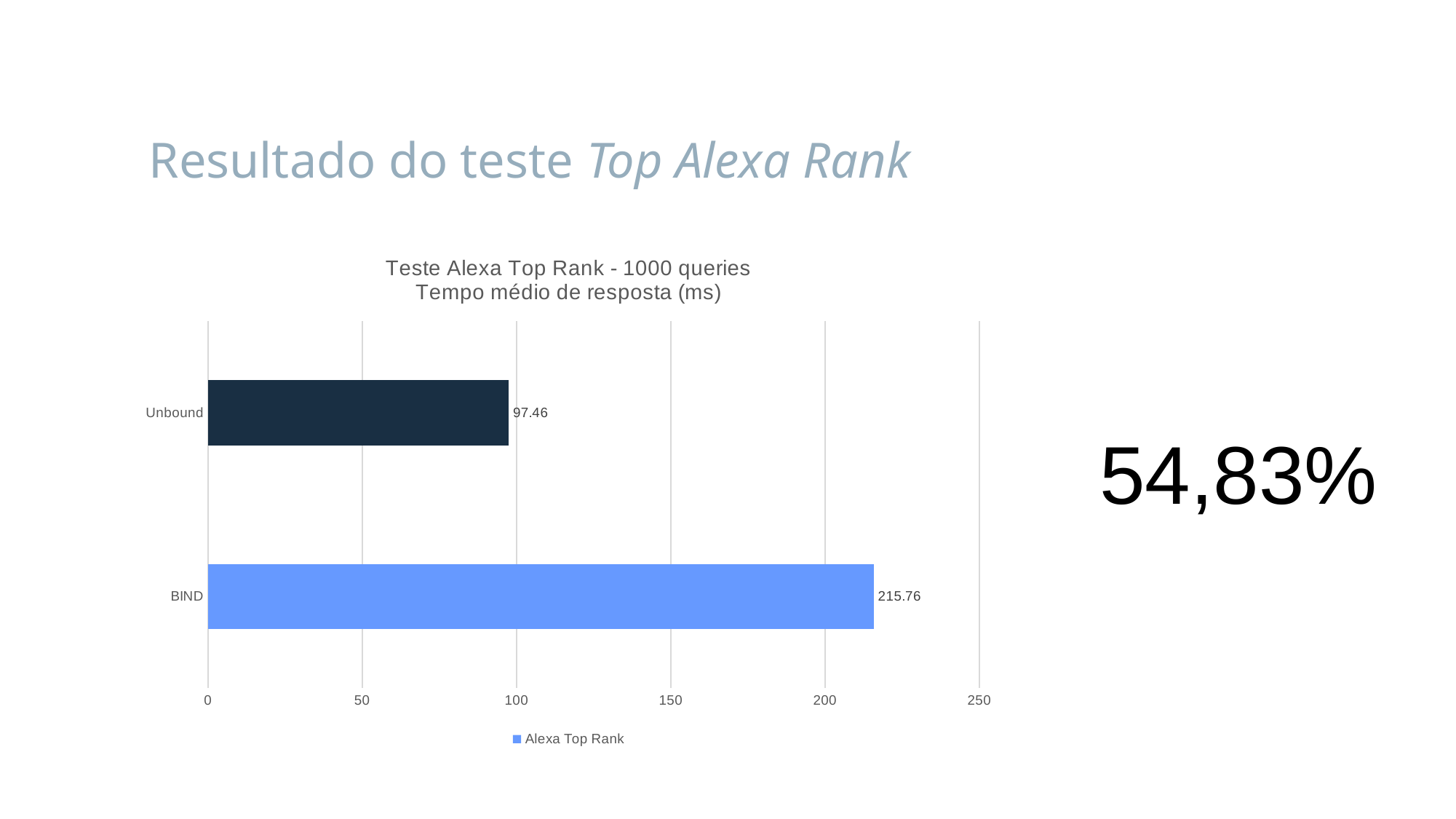
Which category has the highest average response time? BIND What is the name of the series listed in the legend? Alexa Top Rank What is the average response time for Unbound? 97.46 What is the average response time for BIND? 215.76 What kind of chart is shown on the slide? bar chart Is the value for BIND greater or less than 200? greater Is the value for Unbound greater or less than 100? less How many categories are shown in the chart? 2 Which category has the lowest average response time? Unbound How many series does the legend list? 1 What is the difference between the BIND and Unbound response times? 118.3 Which has a larger value, BIND or Unbound? BIND